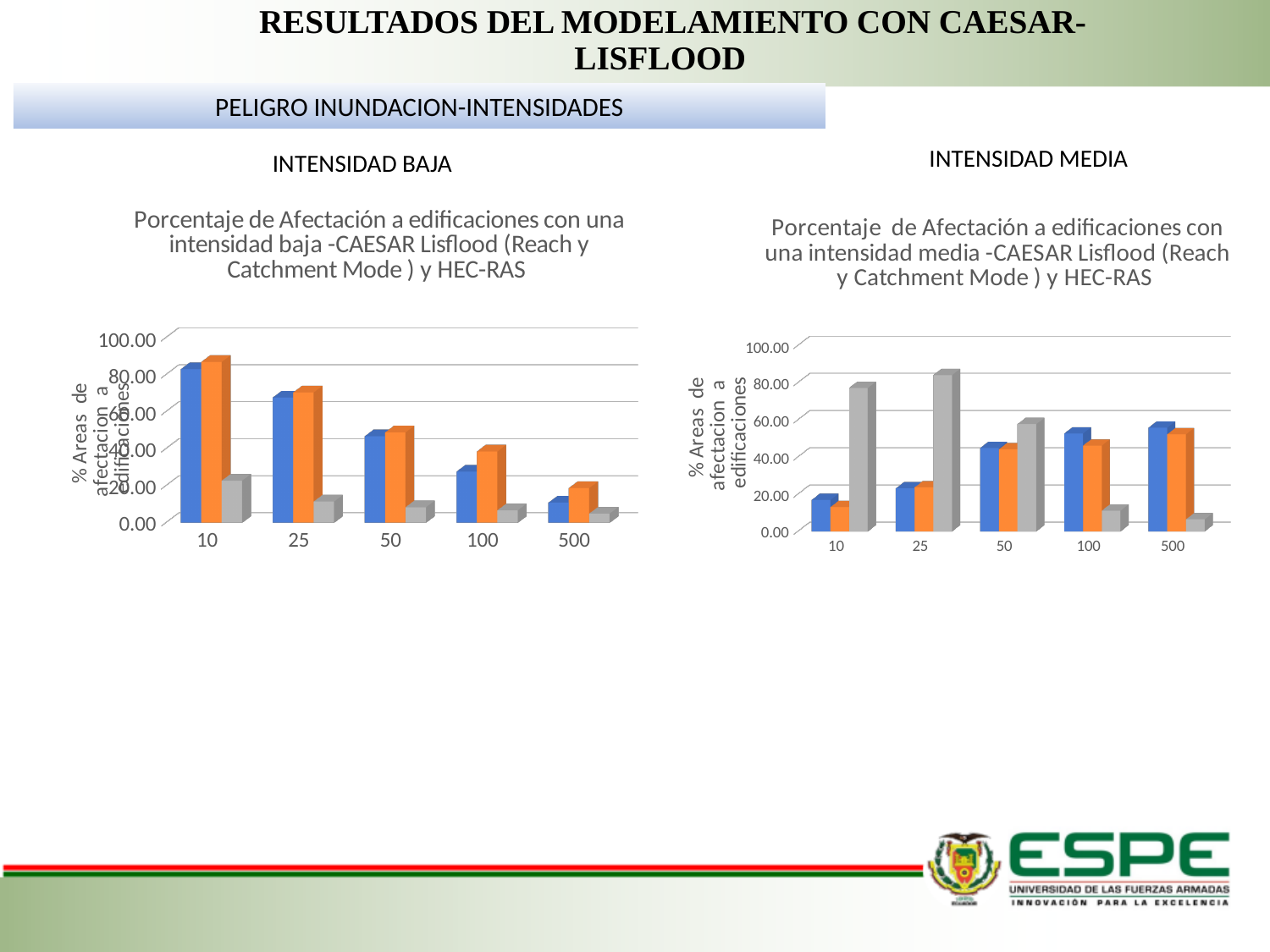
In the right chart (intensidad media), is the value of the gray bar for category 25 greater or less than 80.00? greater In the left chart (intensidad baja), is the value of the blue bar for category 10 greater or less than 60.00? greater What kind of chart is the left chart, 'Porcentaje de Afectación a edificaciones con una intensidad baja'? bar chart How many categories are shown on the x axis of the left chart (intensidad baja)? 5 In the left chart (intensidad baja), do the blue bars rise or fall as the x axis goes from 10 to 500? fall In the right chart (intensidad media), is the value of the gray bar for category 500 greater or less than 20.00? less In the left chart (intensidad baja), which category has the lowest blue bar? 500 What is the y-axis label of the right chart (intensidad media)? % Areas de afectacion a edificaciones In the left chart (intensidad baja), which category has the highest orange bar? 10 In the right chart (intensidad media), which category has the highest gray bar? 25 In the right chart (intensidad media), which is larger for category 10: the blue bar or the gray bar? the gray bar